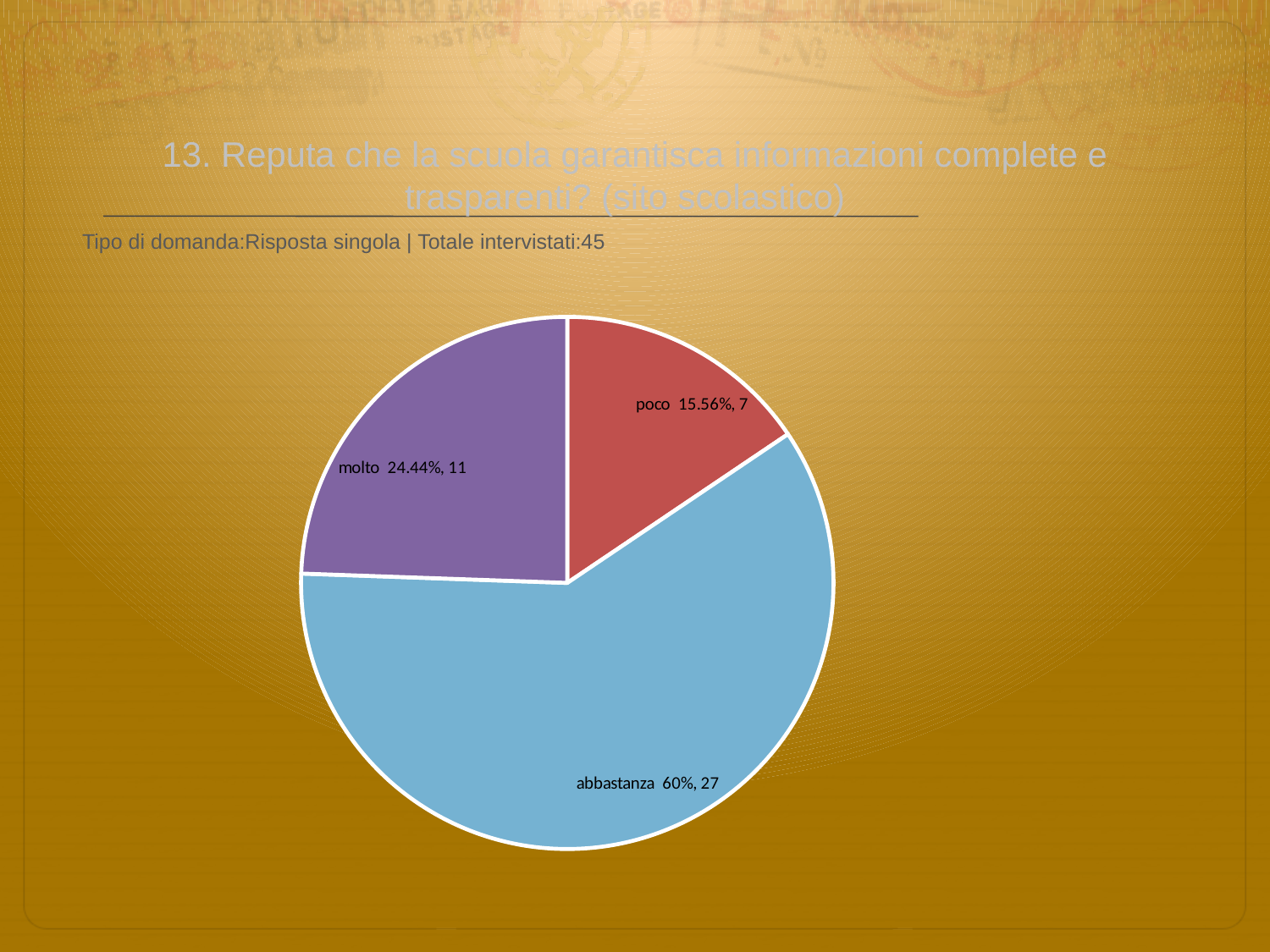
Which response has the smallest slice of the pie? poco How many slices does the pie chart have? 3 How many more respondents answered 'abbastanza' than 'molto'? 16 What percentage share does the 'poco' slice have? 15.56% What percentage share does the 'abbastanza' slice have? 60% How many respondents answered 'poco'? 7 How many respondents answered 'abbastanza'? 27 What percentage share does the 'molto' slice have? 24.44% What kind of chart is shown on the slide? pie chart How many respondents answered 'molto'? 11 Which slice is larger, 'molto' or 'poco'? molto Which response has the largest slice of the pie? abbastanza